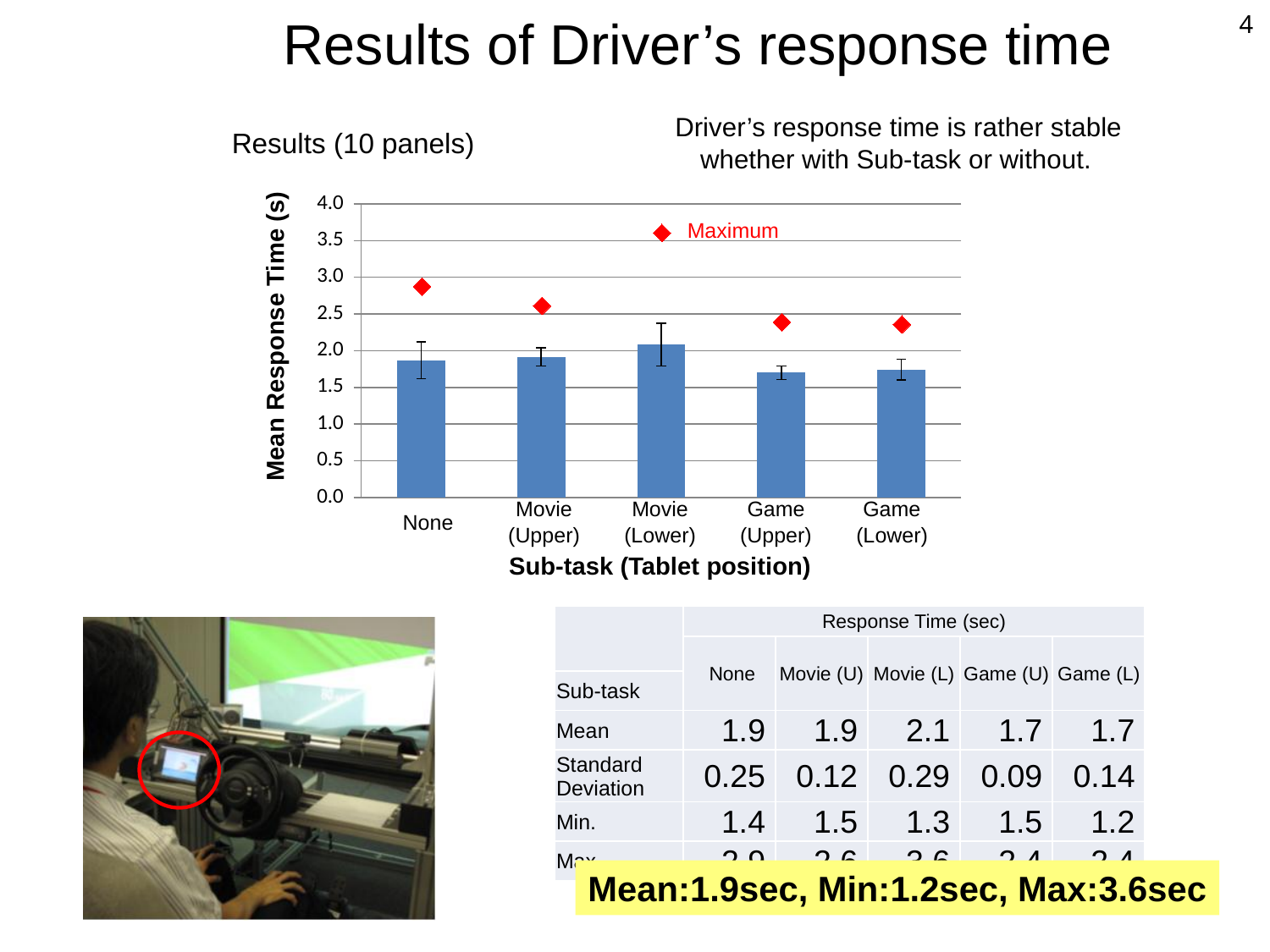
Is the Maximum marker for None greater or less than 2.5? greater What is the title of the y axis of the chart? Mean Response Time (s) What kind of chart is shown on the slide? bar chart Is the mean response time bar for Game (Upper) greater or less than 1.5? greater How many sub-task categories are shown on the x axis of the chart? 5 Which sub-task has the highest mean response time bar? Movie (Lower) Which has the larger mean response time bar, Movie (Lower) or Game (Upper)? Movie (Lower) Is the Maximum marker for Game (Upper) greater or less than 2.5? less What do the red diamond markers on the chart represent? Maximum Which sub-task has the highest Maximum marker? Movie (Lower)